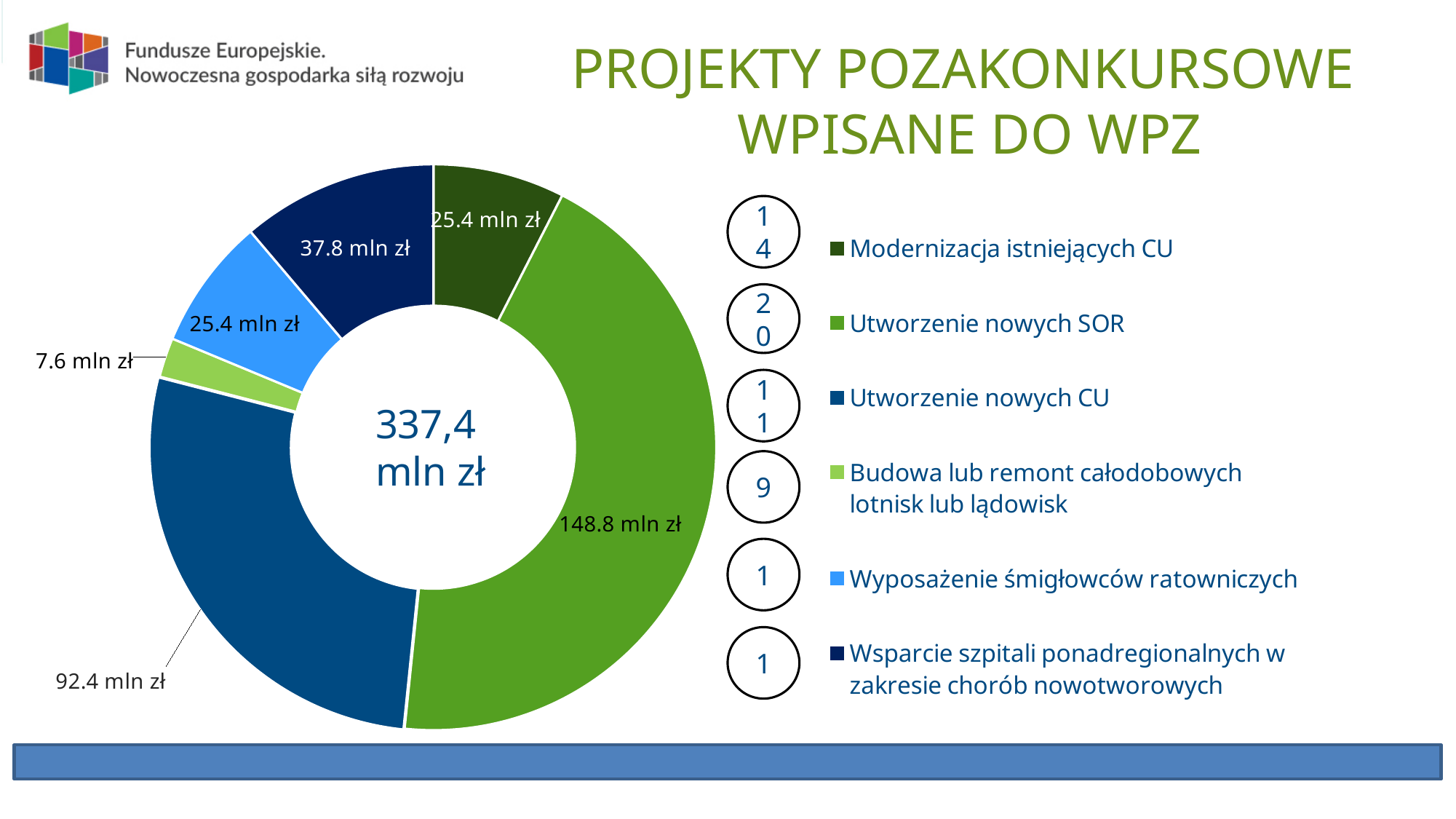
What value is shown for Utworzenie nowych CU? 92.4 mln zł What value is shown for Budowa lub remont całodobowych lotnisk lub lądowisk? 7.6 mln zł Which category has the largest value in the chart? Utworzenie nowych SOR What total value is printed in the centre of the chart? 337,4 mln zł What colour is the slice for Wyposażenie śmigłowców ratowniczych? light blue What is the difference between the values for Utworzenie nowych SOR and Utworzenie nowych CU? 56.4 mln zł How many categories does the chart show? 6 Which category has the smallest value in the chart? Budowa lub remont całodobowych lotnisk lub lądowisk What value is shown for Wsparcie szpitali ponadregionalnych w zakresie chorób nowotworowych? 37.8 mln zł Which is larger: the value for Wsparcie szpitali ponadregionalnych w zakresie chorób nowotworowych or the value for Wyposażenie śmigłowców ratowniczych? Wsparcie szpitali ponadregionalnych w zakresie chorób nowotworowych What kind of chart is shown on the slide? doughnut chart What value is shown for Utworzenie nowych SOR? 148.8 mln zł